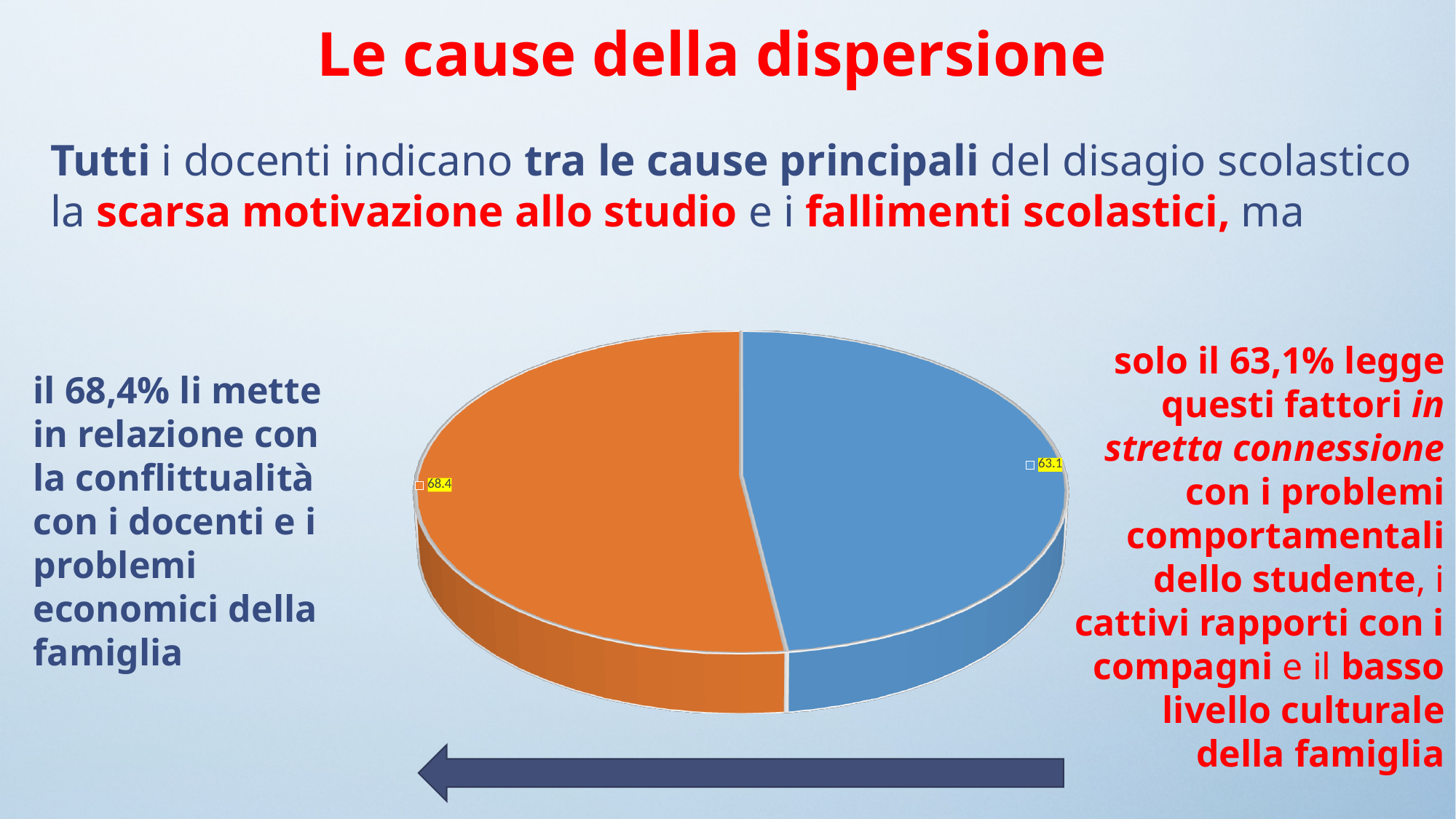
What value is labelled on the blue slice of the pie chart? 63.1 What is the difference between the values of the orange slice and the blue slice? 5.3 Which slice of the pie chart has the highest value? the orange slice (68.4) Is the value of the blue slice greater or less than 65? less What colours are used for the two slices of the pie chart? orange and blue What value is labelled on the orange slice of the pie chart? 68.4 Does the pie chart have a legend? No Which slice of the pie chart has the lowest value? the blue slice (63.1) How many slices does the pie chart have? 2 What kind of chart is shown on the slide? pie chart Is the value of the orange slice larger or smaller than the value of the blue slice? larger